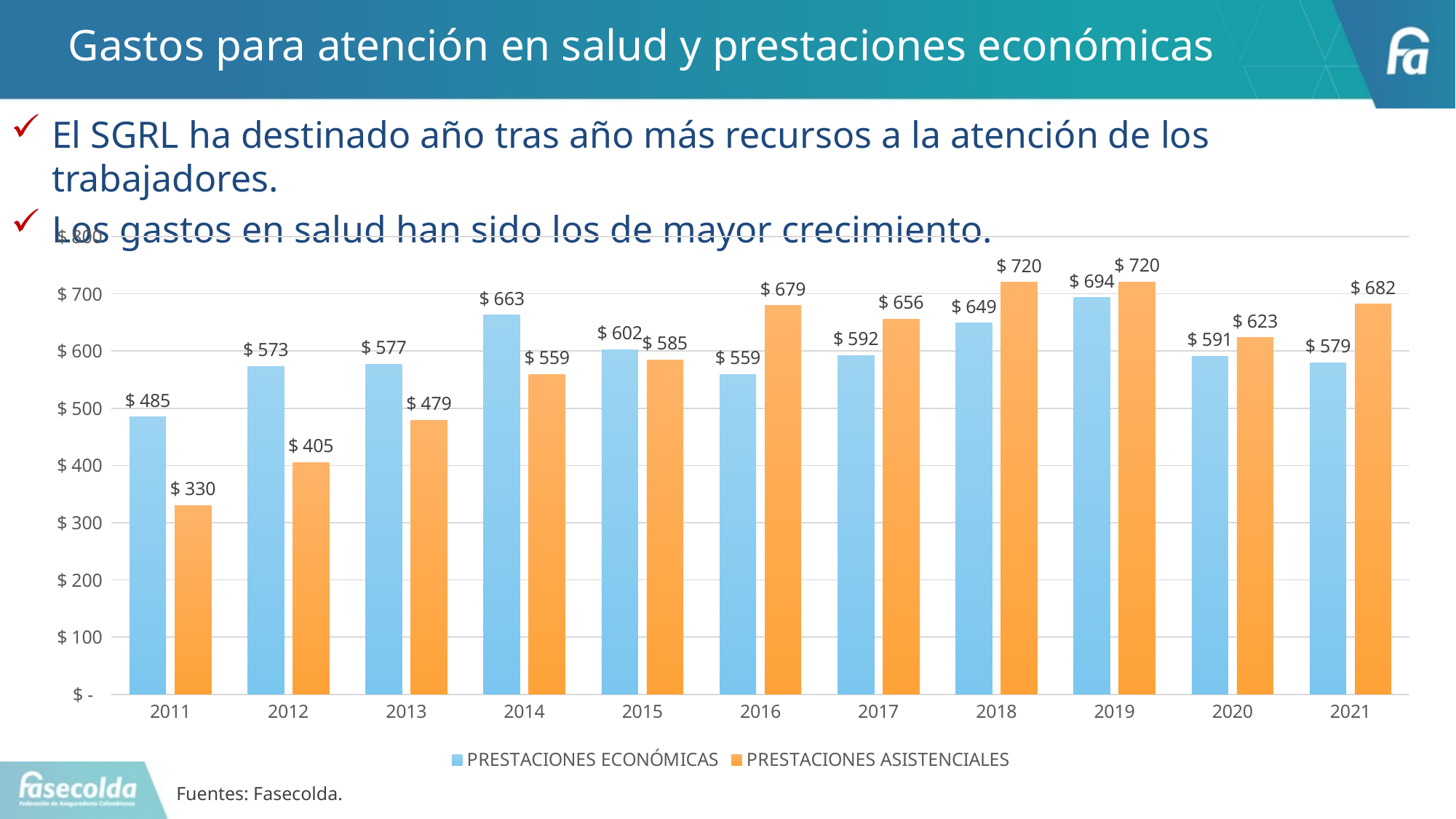
How many years are shown on the x axis of the chart? 11 What is the difference between PRESTACIONES ASISTENCIALES and PRESTACIONES ECONÓMICAS in 2021? $ 103 What is the difference between PRESTACIONES ECONÓMICAS and PRESTACIONES ASISTENCIALES in 2011? $ 155 In which year is PRESTACIONES ASISTENCIALES lowest? 2011 How many series does the legend list? 2 Does PRESTACIONES ASISTENCIALES generally rise or fall from 2011 to 2021? Rise What is the value for PRESTACIONES ECONÓMICAS in 2014? $ 663 In which year is PRESTACIONES ECONÓMICAS highest? 2019 What is the value for PRESTACIONES ASISTENCIALES in 2011? $ 330 What is the value for PRESTACIONES ASISTENCIALES in 2016? $ 679 In 2014, which series is larger, PRESTACIONES ECONÓMICAS or PRESTACIONES ASISTENCIALES? PRESTACIONES ECONÓMICAS What kind of chart is shown on the slide? Bar chart